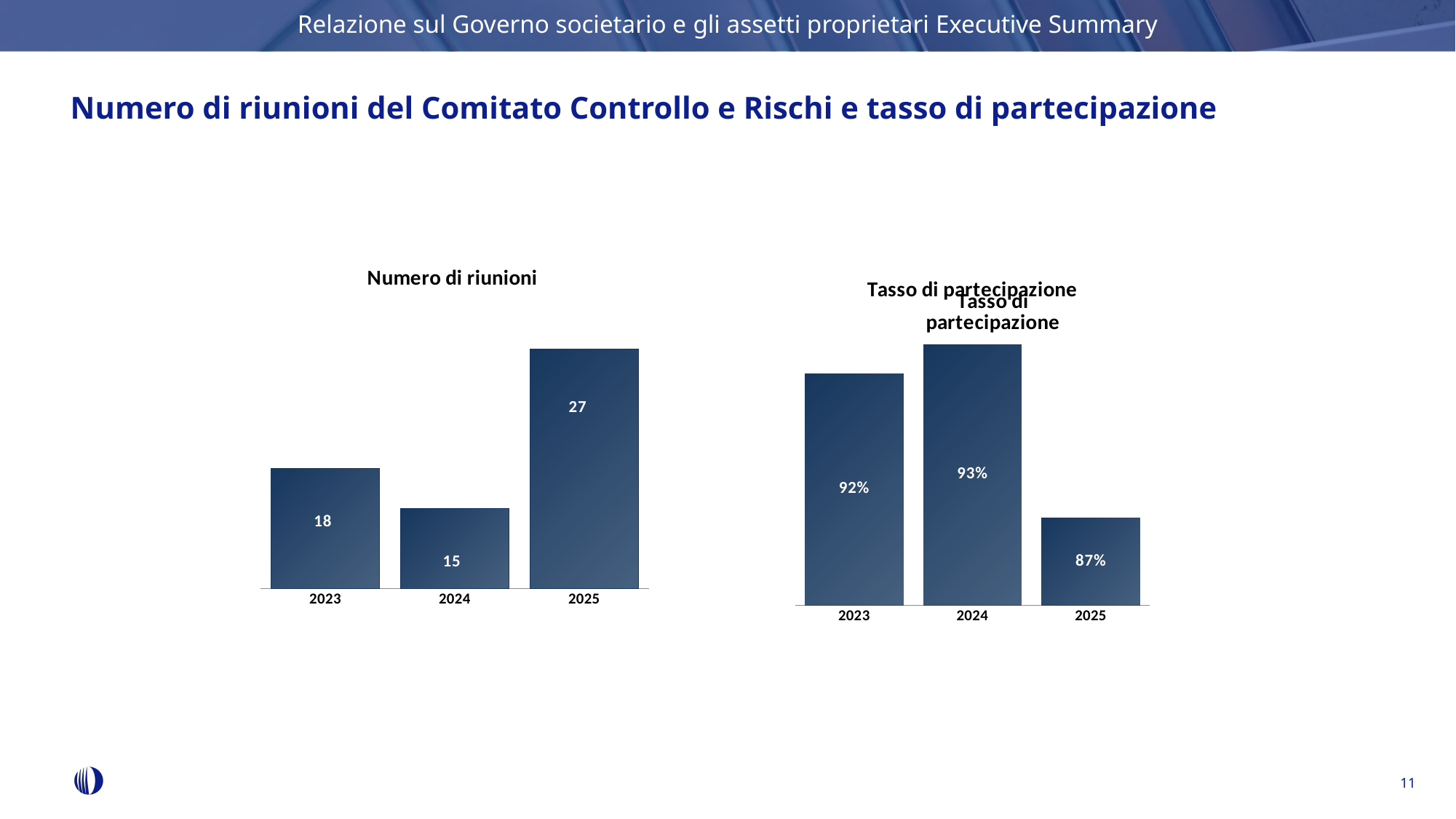
How many years are shown in the 'Tasso di partecipazione' chart? 3 What kind of chart is the 'Numero di riunioni' chart? Bar chart In the 'Numero di riunioni' chart, what is the value for 2024? 15 In the 'Tasso di partecipazione' chart, what is the value for 2023? 92% In the 'Numero di riunioni' chart, what is the difference between the values for 2025 and 2024? 12 In the 'Numero di riunioni' chart, which year has the highest value? 2025 In the 'Numero di riunioni' chart, which year has the lowest value? 2024 In the 'Numero di riunioni' chart, what is the value for 2025? 27 In the 'Numero di riunioni' chart, which is larger, the value for 2023 or the value for 2024? 2023 In the 'Tasso di partecipazione' chart, what is the difference between the values for 2024 and 2025? 6% In the 'Tasso di partecipazione' chart, what is the value for 2025? 87% In the 'Tasso di partecipazione' chart, which year has the lowest value? 2025